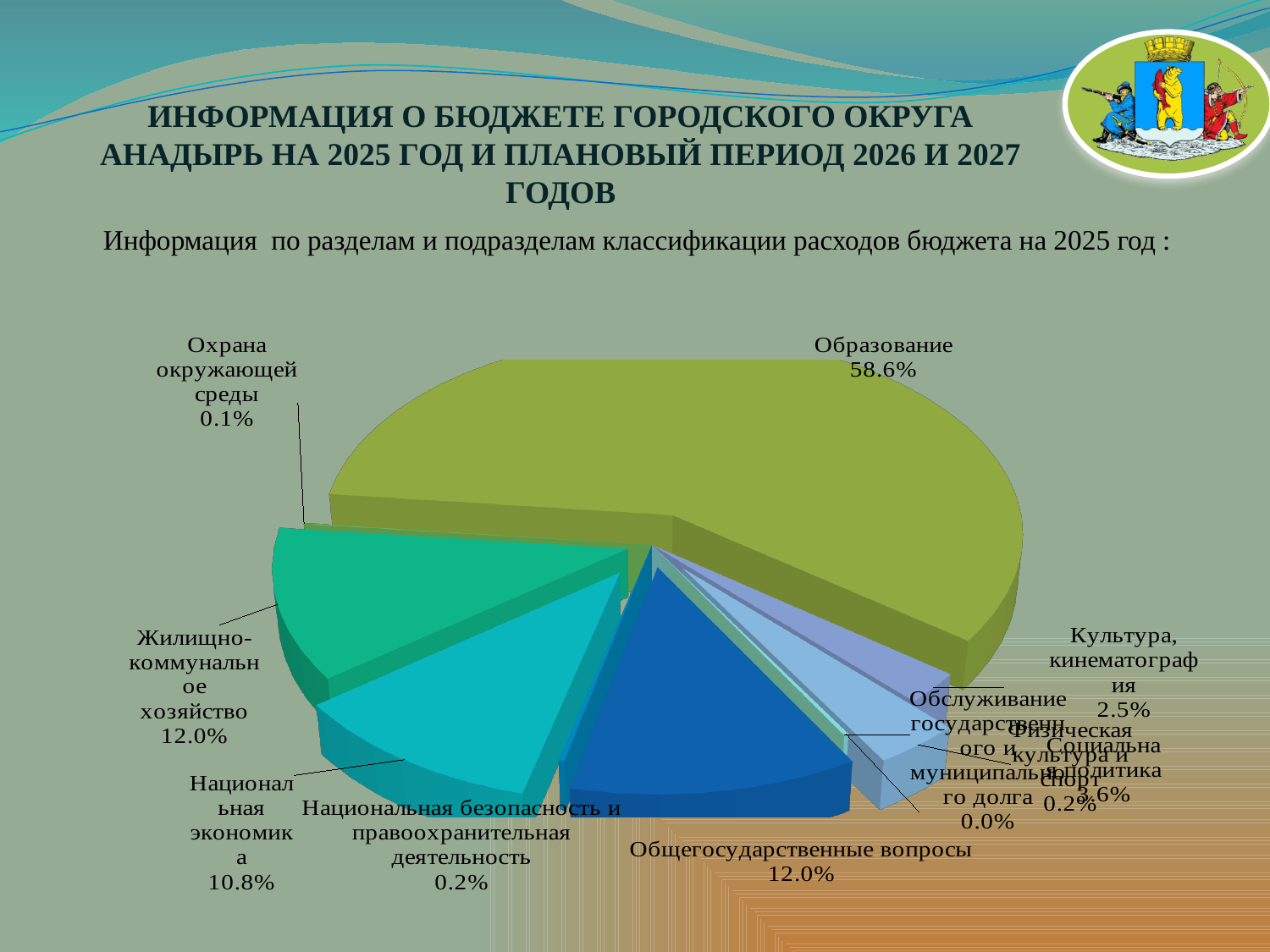
By how many percentage points does Образование exceed Общегосударственные вопросы? 46.6 What share of the pie is Жилищно-коммунальное хозяйство? 12.0% What share is shown for Социальная политика? 3.6% Which category has the smallest share, shown as 0.0%? Обслуживание государственного и муниципального долга How many categories (slices) does the pie chart show? 10 What kind of chart is shown on the slide? pie chart What is the value shown for Национальная экономика? 10.8% What is the value for Культура, кинематография? 2.5% What share of the 2025 budget expenditure goes to Образование? 58.6% What percentage is shown for Охрана окружающей среды? 0.1% Which is larger: the share for Национальная экономика or the share for Социальная политика? Национальная экономика Which category has the largest share of the pie? Образование